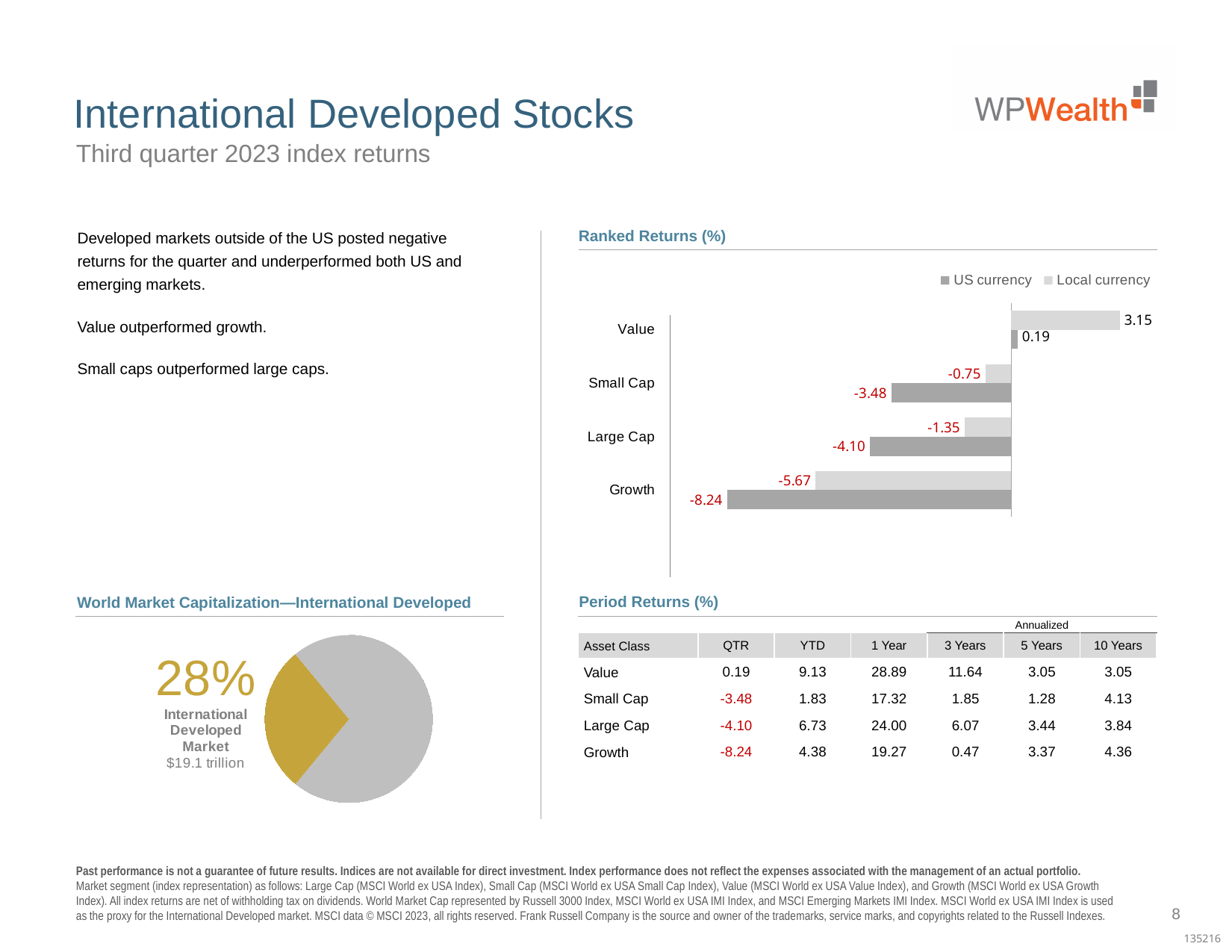
In the Ranked Returns (%) chart, which category has the lowest US currency return? Growth In the Ranked Returns (%) chart, what is the difference between the Local currency and US currency returns for Growth? 2.57 In the Ranked Returns (%) chart, what is the Local currency return for Small Cap? -0.75 In the Ranked Returns (%) chart, what is the US currency return for Large Cap? -4.10 How many categories are shown in the Ranked Returns (%) chart? 4 How many series does the legend of the Ranked Returns (%) chart list? 2 In the Ranked Returns (%) chart, what is the US currency return for Growth? -8.24 In the Ranked Returns (%) chart, what is the difference between the Local currency and US currency returns for Value? 2.96 In the Ranked Returns (%) chart, which category has the highest Local currency return? Value In the Ranked Returns (%) chart, what is the Local currency return for Value? 3.15 In the World Market Capitalization—International Developed chart, what share of the pie does the International Developed Market represent? 28% In the Ranked Returns (%) chart, which is larger, the US currency return for Small Cap or for Large Cap? Small Cap